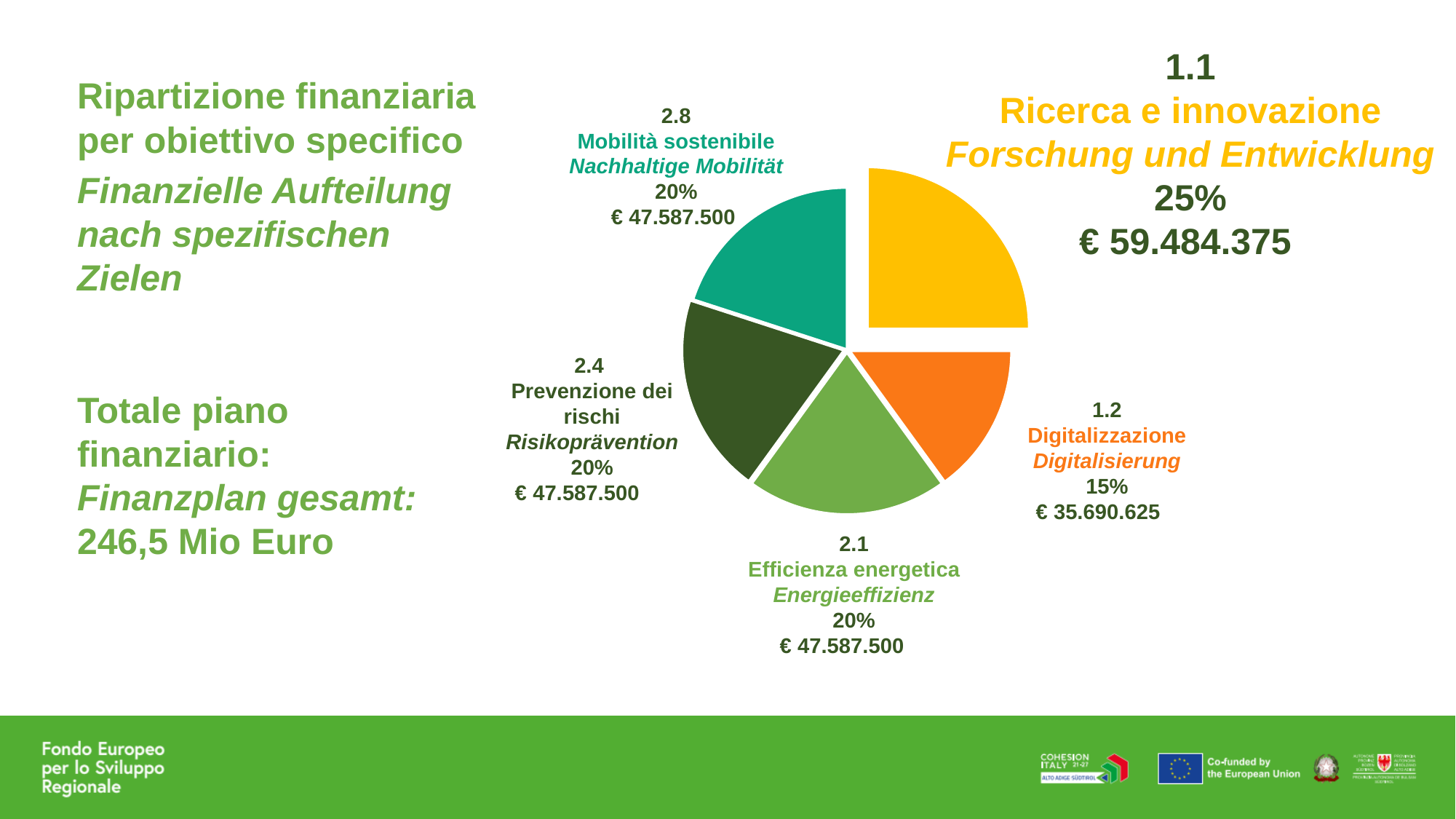
What is the difference in euros between 1.1 Ricerca e innovazione and 1.2 Digitalizzazione? € 23.793.750 What colour is the slice for 1.1 Ricerca e innovazione? yellow How many slices does the pie chart have? 5 Which specific objective has the largest share of the pie chart? 1.1 Ricerca e innovazione Which is larger, the amount for 2.1 Efficienza energetica or the amount for 1.2 Digitalizzazione? 2.1 Efficienza energetica What is the amount shown for 1.2 Digitalizzazione? € 35.690.625 Which specific objective has the smallest share of the pie chart? 1.2 Digitalizzazione What kind of chart is shown on the slide? pie chart What is the amount shown for 2.8 Mobilità sostenibile? € 47.587.500 What percentage share does 2.4 Prevenzione dei rischi have? 20% What percentage share does 1.1 Ricerca e innovazione have in the pie chart? 25% What is the difference in euros between 2.1 Efficienza energetica and 1.2 Digitalizzazione? € 11.896.875